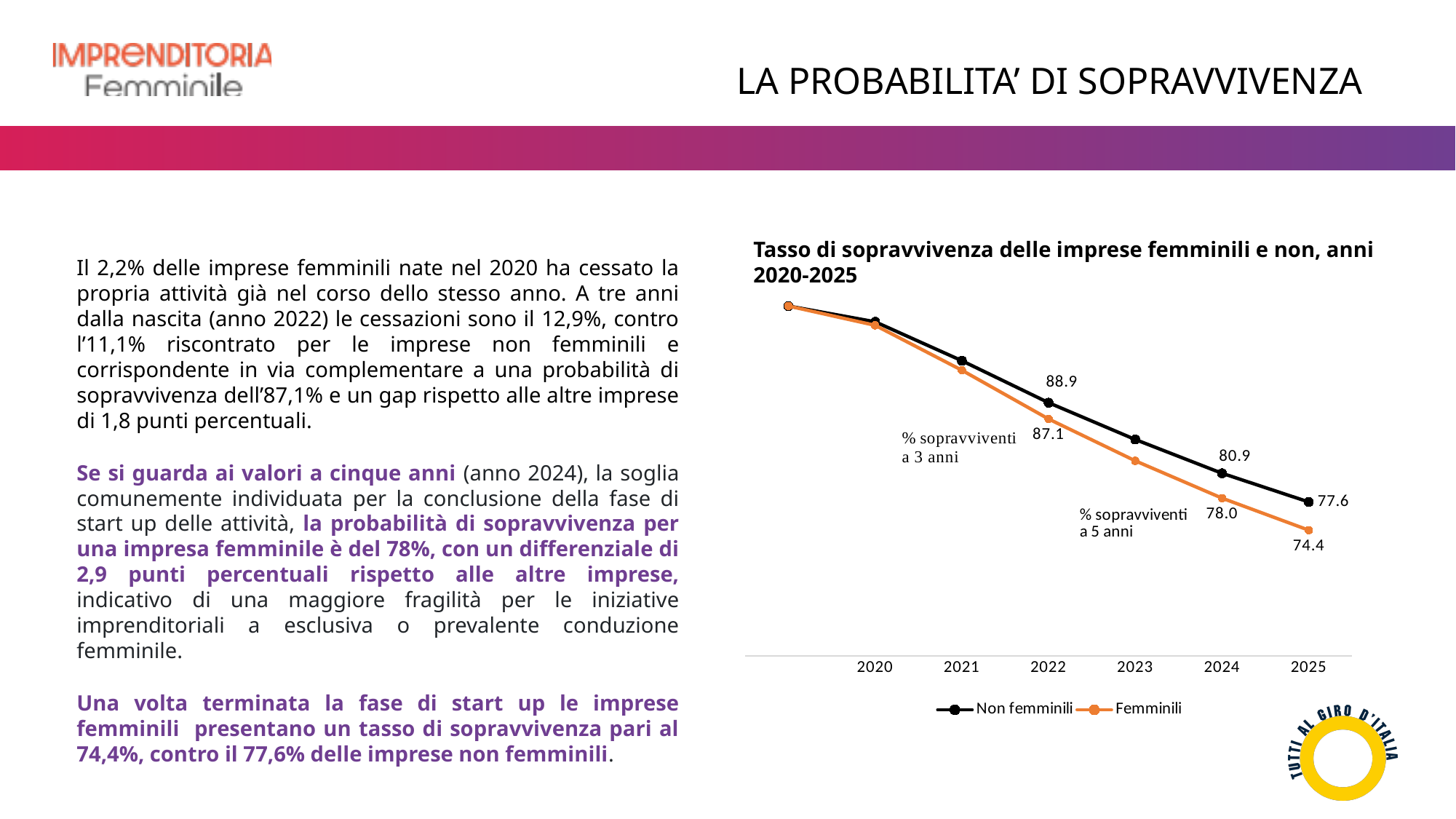
What is the difference between the Non femminili and Femminili values in 2025? 3.2 What is the value for Femminili in 2022? 87.1 What is the value for Femminili in 2024? 78.0 What is the value for Femminili in 2025? 74.4 What is the value for Non femminili in 2022? 88.9 Which series has the higher value in 2024, Non femminili or Femminili? Non femminili What kind of chart is shown on the slide? line chart What is the value for Non femminili in 2024? 80.9 What is the value for Non femminili in 2025? 77.6 What colour is the line for the Femminili series? orange How many series does the chart legend list? 2 Do the values of the Femminili series rise or fall from 2020 to 2025? fall